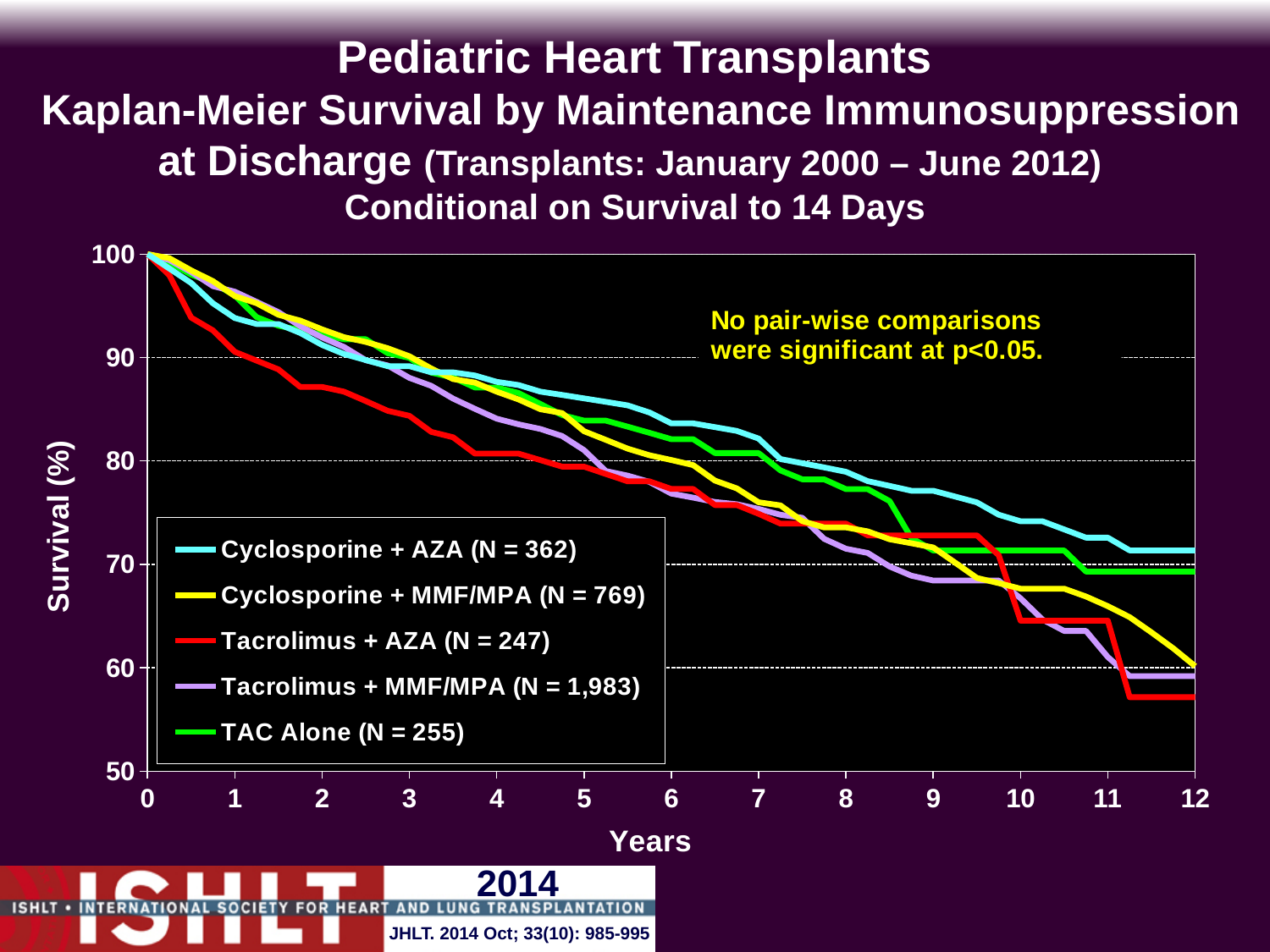
According to the note on the chart, were any pair-wise comparisons significant at p<0.05? No Is the survival for Tacrolimus + AZA at year 12 greater or less than 60? less At year 3, which has higher survival: Cyclosporine + AZA or Tacrolimus + AZA? Cyclosporine + AZA Which series has the lowest survival at year 3? Tacrolimus + AZA Is the survival for Tacrolimus + MMF/MPA at year 10 greater or less than 70? less Which series has the highest survival at year 12? Cyclosporine + AZA Is the survival for Cyclosporine + AZA at year 6 greater or less than 80? greater Do the survival curves rise or fall as the years increase? Fall What kind of chart is shown on the slide? Line chart How many series does the legend list? 5 What is the N for the Tacrolimus + MMF/MPA group shown in the legend? 1,983